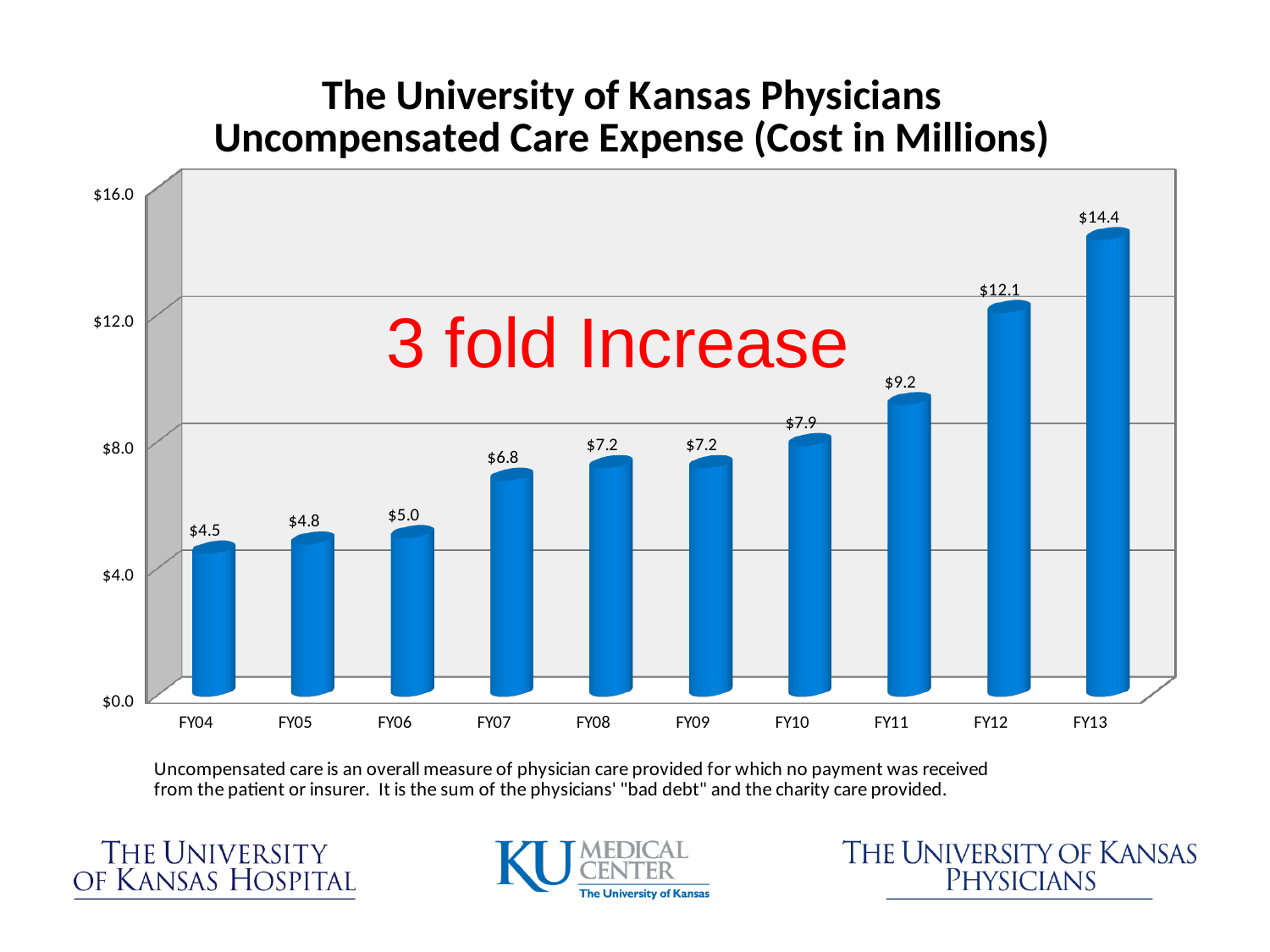
Is the value for FY12 greater or less than $12.0? greater Which fiscal year has the lowest uncompensated care expense? FY04 How many fiscal years are shown on the x axis? 10 What is the uncompensated care expense for FY04? $4.5 What is the difference between the FY13 and FY04 values? $9.9 What is the uncompensated care expense for FY13? $14.4 What is the difference between the FY12 and FY11 values? $2.9 Which fiscal year has the highest uncompensated care expense? FY13 What is the value shown for FY10? $7.9 Do the values generally rise or fall from FY04 to FY13? Rise What kind of chart is shown on the slide? Bar chart Which is larger, the value for FY07 or the value for FY11? FY11